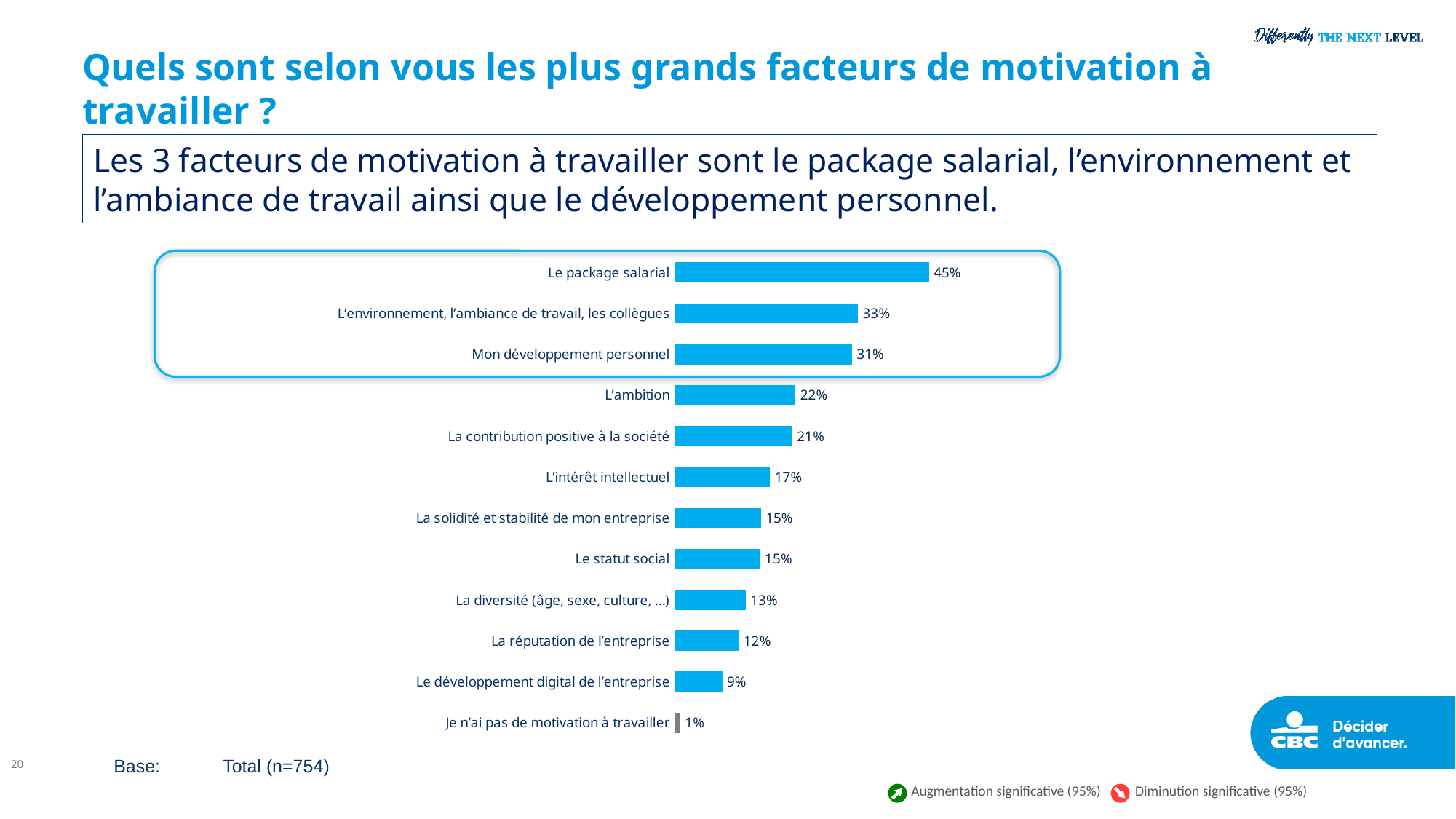
What is the value for "Mon développement personnel"? 31% What is the difference between "L'ambition" and "La réputation de l'entreprise"? 10% What is the value for "L'intérêt intellectuel"? 17% How many categories are shown in the chart? 12 What is the difference between "Le package salarial" and "L'environnement, l'ambiance de travail, les collègues"? 12% What is the base (sample size) shown for the chart? Total (n=754) What is the value for "Le développement digital de l'entreprise"? 9% What is the value for "Le package salarial"? 45% Which category has the lowest value? Je n'ai pas de motivation à travailler Which is larger: "La contribution positive à la société" or "La diversité (âge, sexe, culture, ...)"? La contribution positive à la société Which category has the highest value? Le package salarial What kind of chart is shown on the slide? Bar chart